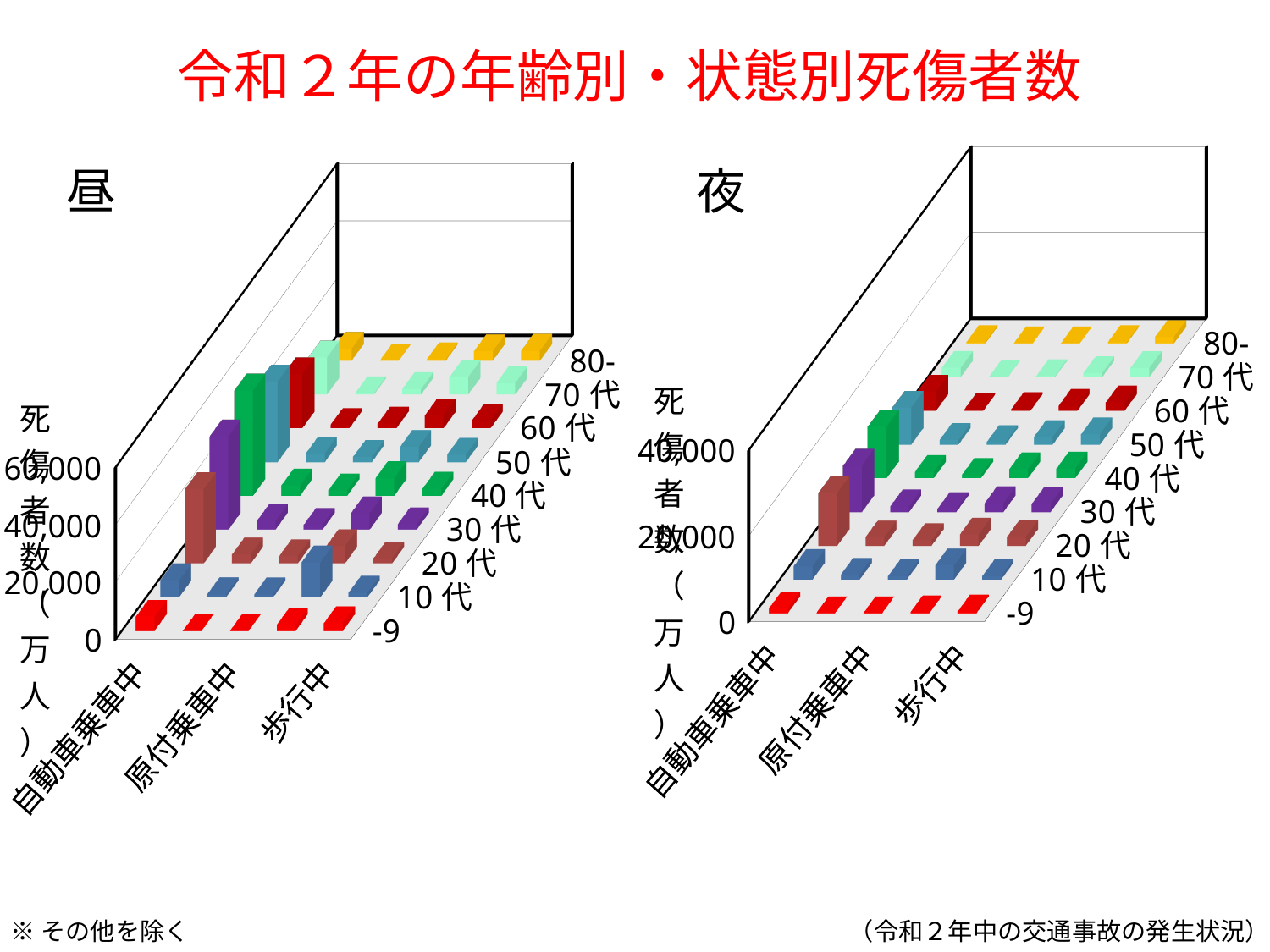
What is the title of the slide? 令和２年の年齢別・状態別死傷者数 In the 昼 chart, which is larger for 自動車乗車中: 30代 or 10代? 30代 In the 昼 chart, what is the highest value shown on the vertical axis? 60,000 How many age groups are plotted in the 夜 chart? 9 What kind of chart is the 昼 chart? bar chart In the 夜 chart, which is larger for 自動車乗車中: 30代 or -9? 30代 In the 夜 chart, what is the highest value shown on the vertical axis? 40,000 How many age groups are plotted in the 昼 chart? 9 In the 昼 chart, which is larger for 20代: 自動車乗車中 or 歩行中? 自動車乗車中